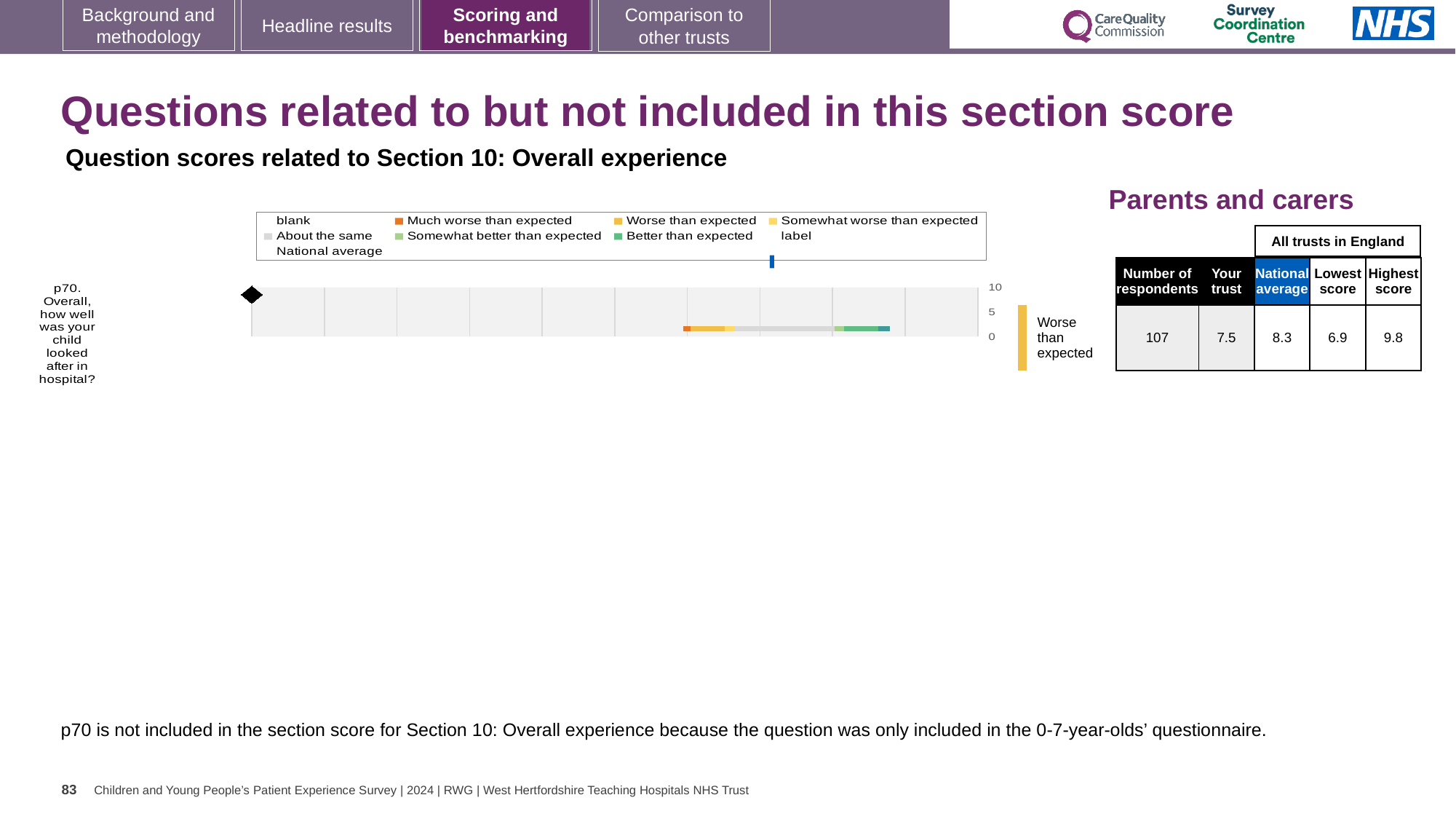
How many survey questions are plotted in the chart? 1 What kind of chart is used to show the p70 question score? bar chart What rating label is shown next to the chart for p70? Worse than expected Which legend entry is shown in orange? Much worse than expected By how much does the national average exceed the 'Your trust' score for p70? 0.8 What is the national average score for p70? 8.3 How many respondents answered p70? 107 What is the lowest score among all trusts in England for p70? 6.9 What is the 'Your trust' score for p70 (Overall, how well was your child looked after in hospital?)? 7.5 Which is larger for p70: the 'Your trust' score or the national average? National average What is the highest score among all trusts in England for p70? 9.8 What is the difference between the highest score and the lowest score for p70? 2.9